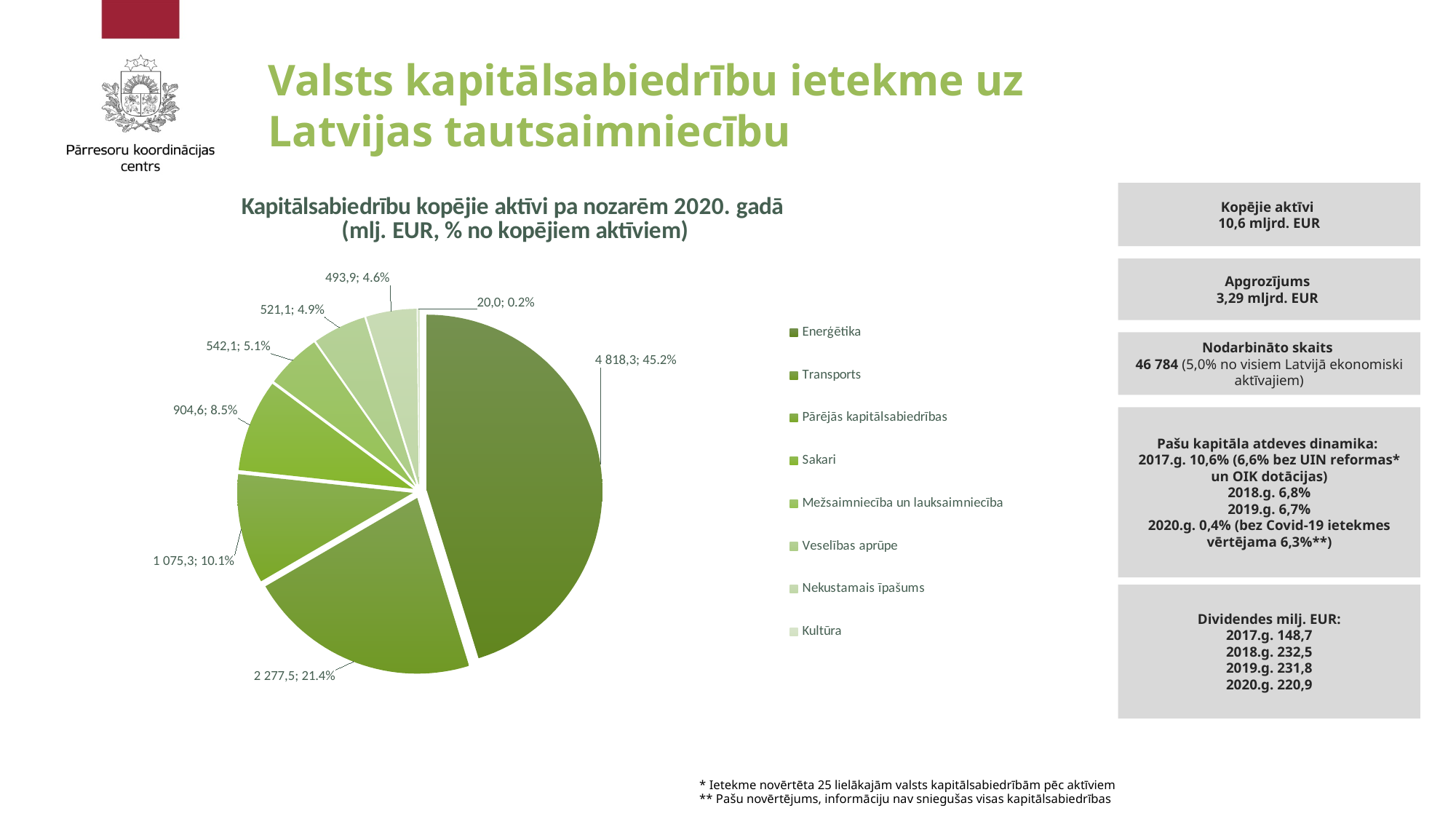
What share of total assets does the Transports slice represent? 21.4% How many sectors does the legend of the pie chart list? 8 What kind of chart is shown on the slide? pie chart What is the value (mlj. EUR) of the Transports slice? 2 277,5 What is the difference in percentage points between the Enerģētika share (45.2%) and the Transports share (21.4%)? 23.8 Which sector has the largest slice of the pie? Enerģētika What is the title of the pie chart? Kapitālsabiedrību kopējie aktīvi pa nozarēm 2020. gadā (mlj. EUR, % no kopējiem aktīviem) What share of total assets does the Sakari slice represent? 8.5% Which sector has the smallest slice of the pie? Kultūra Which is larger, the Pārējās kapitālsabiedrības slice or the Sakari slice? Pārējās kapitālsabiedrības What is the value (mlj. EUR) of the Kultūra slice? 20,0 What share of total assets does the Enerģētika slice represent? 45.2%